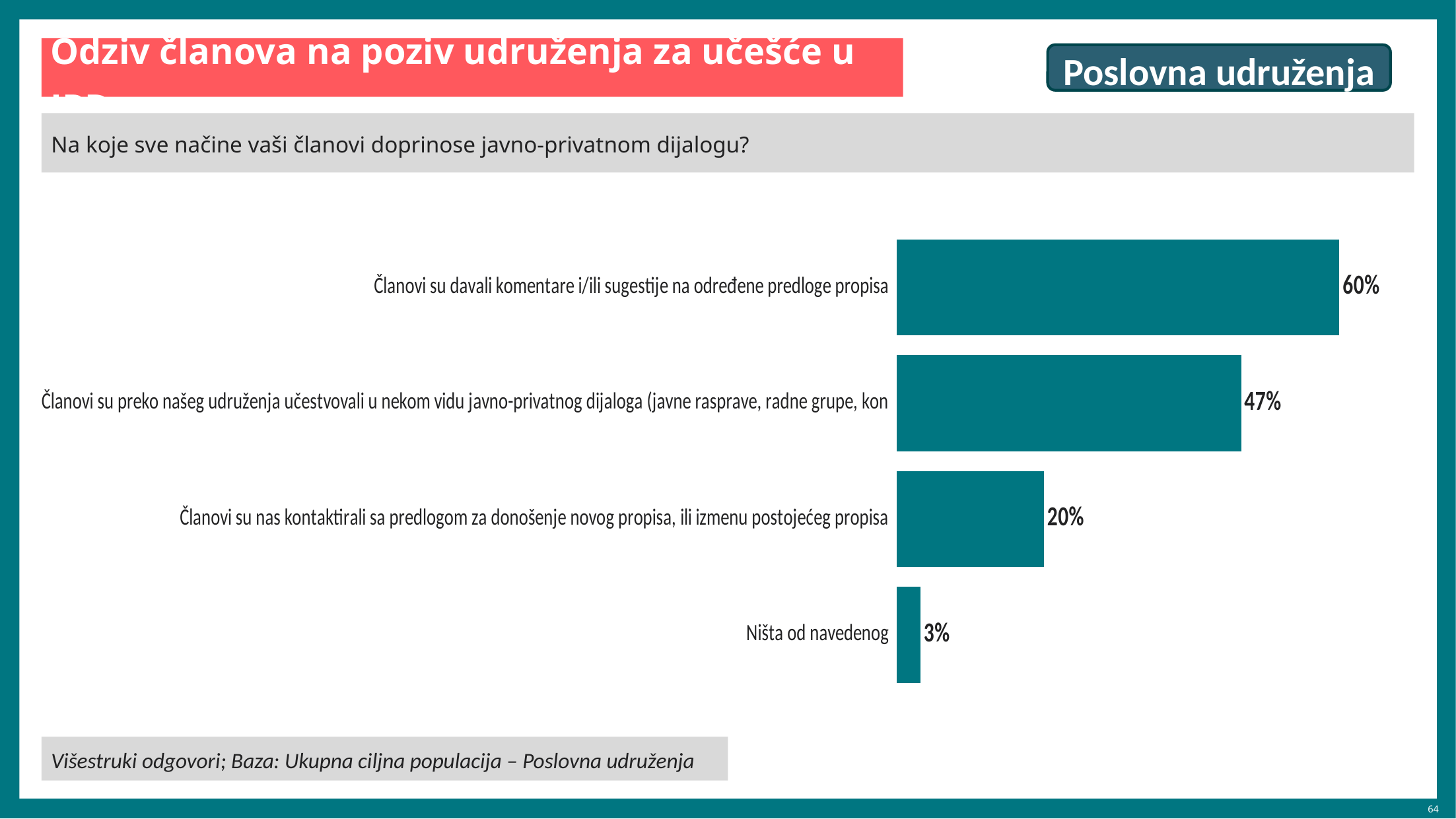
What percentage is shown for the category about members participating through the association in some form of public-private dialogue (javne rasprave, radne grupe...)? 47% What is the difference in percentage points between "Članovi su nas kontaktirali sa predlogom za donošenje novog propisa, ili izmenu postojećeg propisa" and "Ništa od navedenog"? 17 Which category has the lowest value? Ništa od navedenog What percentage is shown for "Ništa od navedenog"? 3% What question is the chart answering, as shown in the grey box above it? Na koje sve načine vaši članovi doprinose javno-privatnom dijalogu? What is the difference in percentage points between the highest category (60%) and the category at 47%? 13 What kind of chart is shown on the slide? Bar chart What percentage is shown for "Članovi su davali komentare i/ili sugestije na određene predloge propisa"? 60% Which is larger: the value for members giving comments/suggestions on proposed regulations, or the value for members contacting the association with a proposal for a new regulation? Članovi su davali komentare i/ili sugestije na određene predloge propisa How many categories are shown in the chart? 4 What percentage is shown for "Članovi su nas kontaktirali sa predlogom za donošenje novog propisa, ili izmenu postojećeg propisa"? 20% Which category has the highest value? Članovi su davali komentare i/ili sugestije na određene predloge propisa